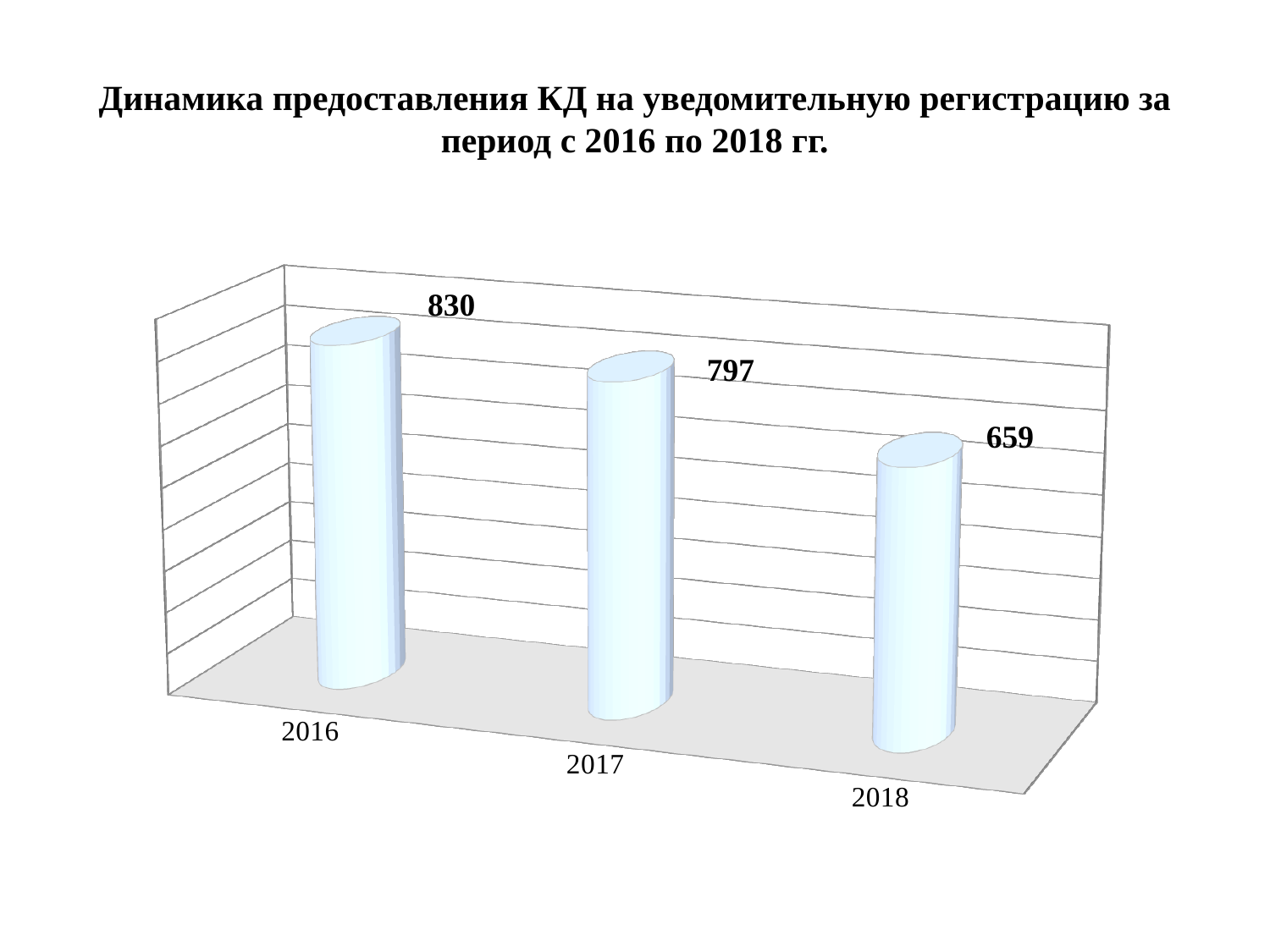
What is the value for 2018? 659 What is the difference between the values for 2017 and 2018? 138 Which year has the highest value? 2016 What is the value for 2016? 830 What is the title of the chart? Динамика предоставления КД на уведомительную регистрацию за период с 2016 по 2018 гг. How many years are shown on the chart? 3 What is the difference between the values for 2016 and 2018? 171 Which year has the lowest value? 2018 What is the value for 2017? 797 Do the values rise or fall from 2016 to 2018? fall What kind of chart is shown on the slide? bar chart Which is larger, the value for 2017 or the value for 2018? 2017